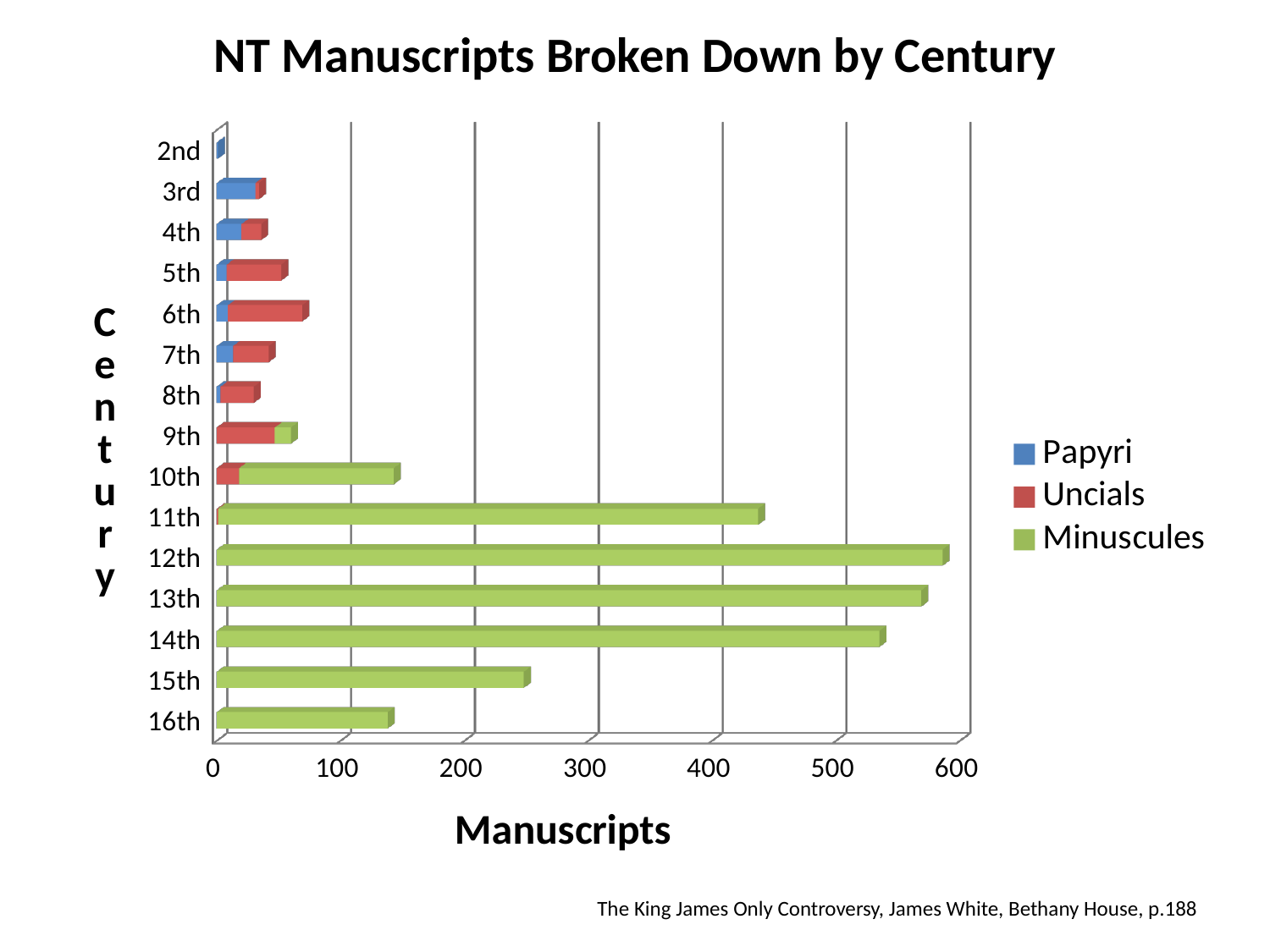
What kind of chart is shown on the slide? bar chart What is the title of the chart? NT Manuscripts Broken Down by Century Is the total value for the 11th century greater or less than 400? greater How many series does the legend list? 3 Which century has a longer total bar, the 12th or the 14th? 12th How many century categories are plotted on the chart? 15 Is the total value for the 14th century greater or less than 500? greater Do the total manuscript counts rise or fall from the 12th century to the 16th century? fall Which century has the smallest total number of manuscripts? 2nd Is the total value for the 15th century greater or less than 200? greater Which series is shown in green in the legend? Minuscules